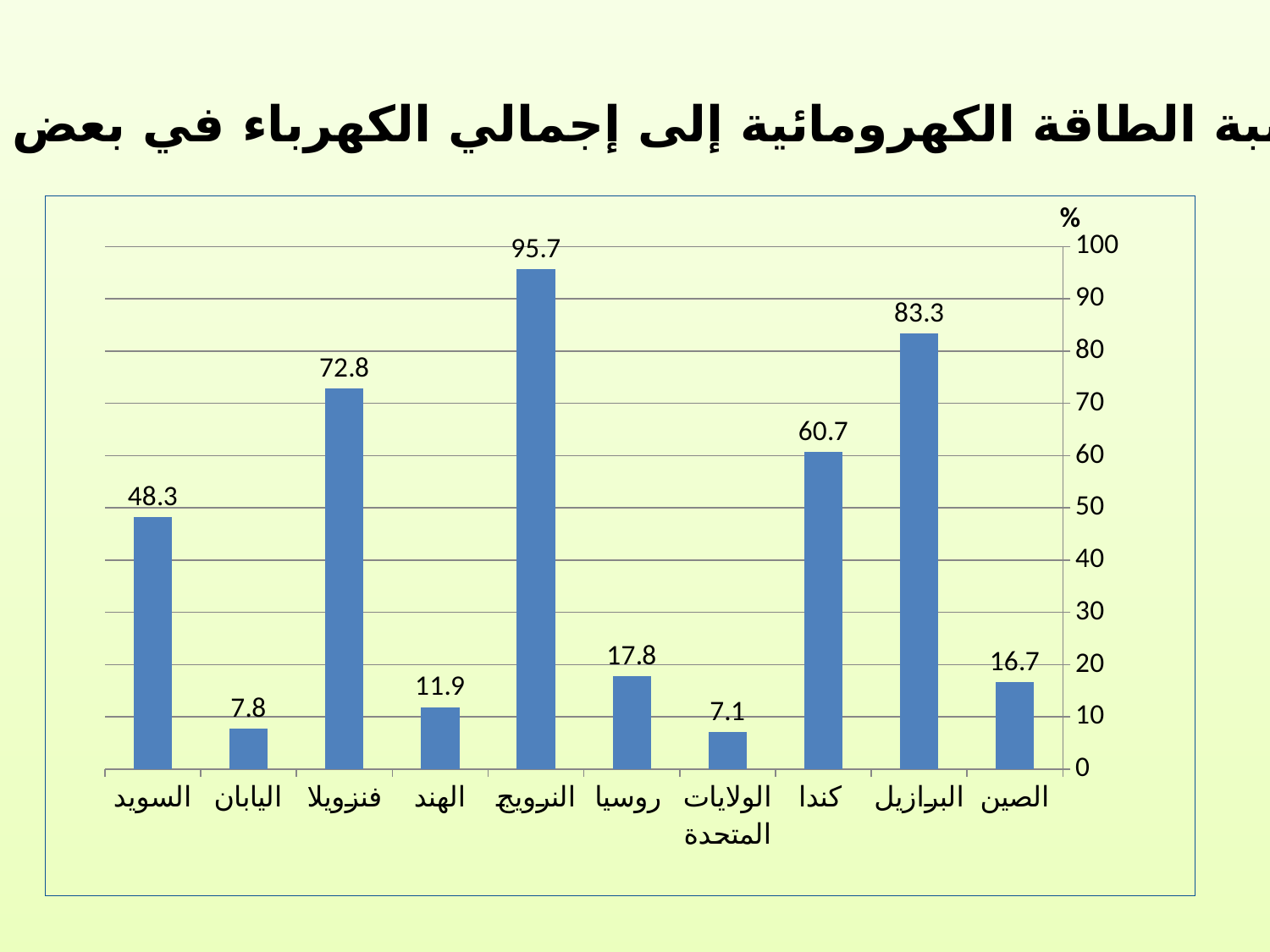
Which country has the highest value? النرويج (Norway) What unit symbol is shown at the top of the vertical axis? % What kind of chart is shown on the slide? bar chart Is the value for كندا (Canada) greater or less than 50? greater What is the value for الصين (China)? 16.7 What is the difference between the values for السويد (Sweden) and اليابان (Japan)? 40.5 What is the value for النرويج (Norway)? 95.7 Which is larger, the value for روسيا (Russia) or the value for الهند (India)? روسيا (Russia) Which country has the lowest value? الولايات المتحدة (United States) What is the value for كندا (Canada)? 60.7 What is the difference between the values for البرازيل (Brazil) and فنزويلا (Venezuela)? 10.5 How many countries are shown on the chart? 10